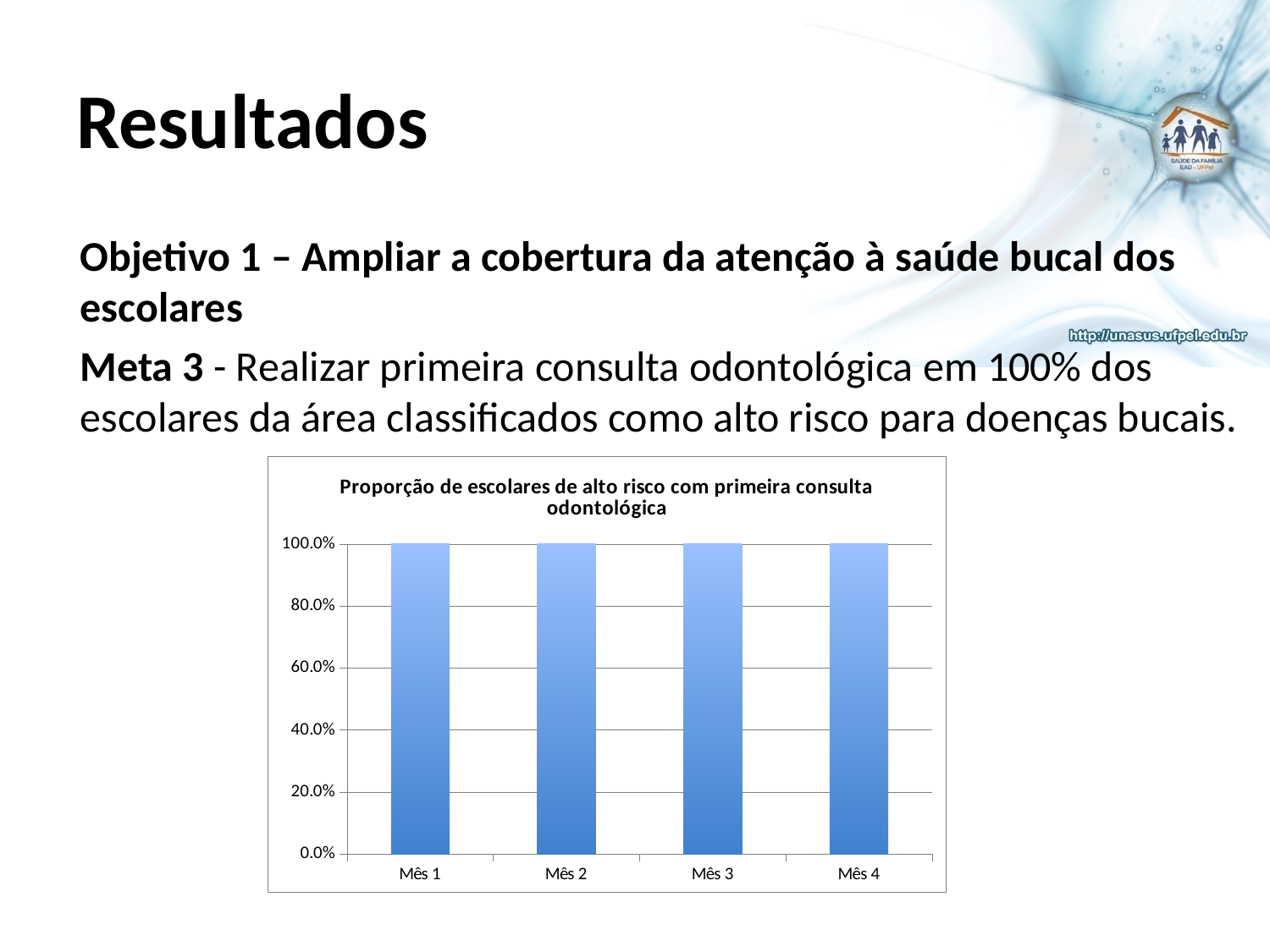
What is the title of the chart? Proporção de escolares de alto risco com primeira consulta odontológica What type of chart is shown on the slide? bar chart What is the value for Mês 1 in the chart? 100.0% How many months (categories) are shown on the x axis of the chart? 4 What is the value for Mês 2 in the chart? 100.0% Do the values rise, fall, or stay the same from Mês 1 to Mês 4? stay the same What is the difference between the values for Mês 1 and Mês 4? 0.0% What is the label of the first category on the x axis? Mês 1 What is the value for Mês 3 in the chart? 100.0% Is the value for Mês 3 greater or less than 80.0%? greater What is the value for Mês 4 in the chart? 100.0% Is the value for Mês 1 greater or less than 60.0%? greater